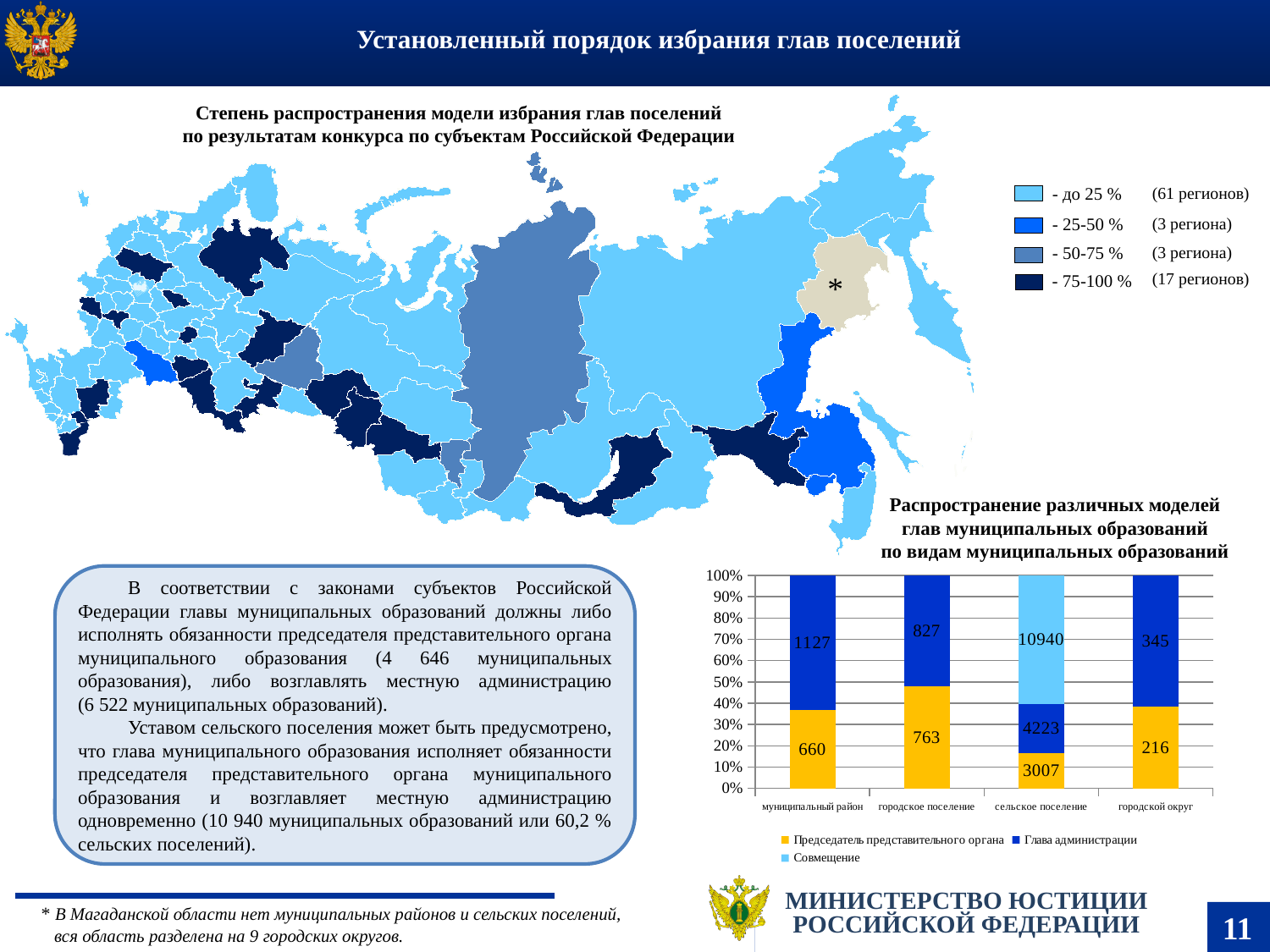
In the bar chart, what is the value for «Председатель представительного органа» in the «городской округ» category? 216 In the bar chart, what is the total of the «городское поселение» bar? 1590 In the bar chart, which category has the highest value for «Председатель представительного органа»? сельское поселение In the bar chart, how many categories are shown on the x axis? 4 In the bar chart, what is the value for «Совмещение» in the «сельское поселение» category? 10940 In the bar chart, which category has the lowest value for «Глава администрации»? городской округ According to the map legend, how many regions fall into the «75-100 %» category? 17 регионов In the bar chart, which is larger in the «городское поселение» category: «Председатель представительного органа» or «Глава администрации»? Глава администрации How many series does the legend of the bar chart list? 3 What kind of chart is the chart titled «Распространение различных моделей глав муниципальных образований по видам муниципальных образований»? Stacked bar chart In the bar chart, what is the value for «Глава администрации» in the «муниципальный район» category? 1127 In the bar chart, what is the difference between «Глава администрации» and «Председатель представительного органа» in the «сельское поселение» category? 1216